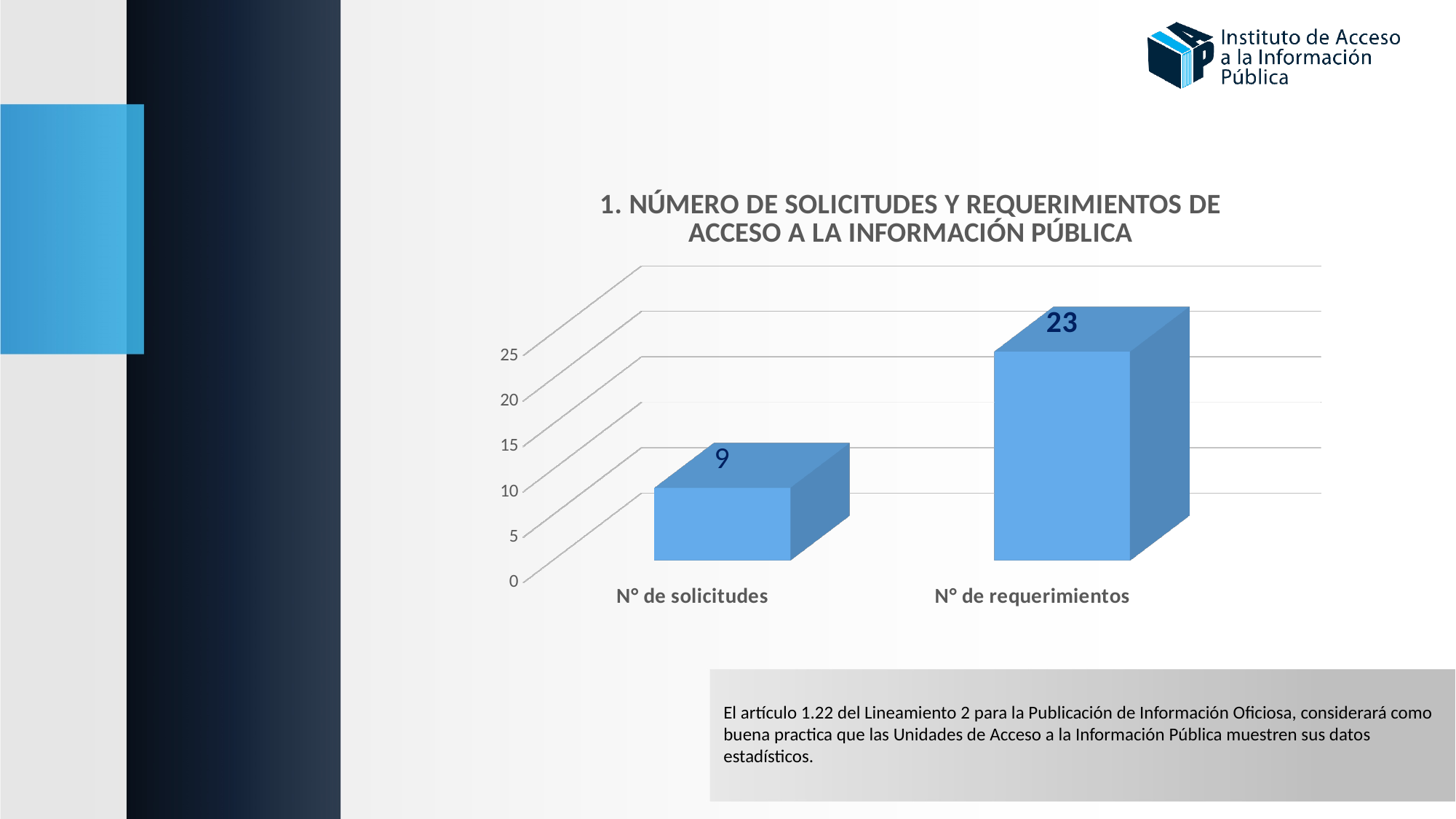
Is the value for N° de solicitudes greater or less than 10? less Which is larger, N° de solicitudes or N° de requerimientos? N° de requerimientos How many categories are shown in the chart? 2 What is the difference between N° de requerimientos and N° de solicitudes? 14 What kind of chart is shown on the slide? bar chart What is the title of the chart? 1. NÚMERO DE SOLICITUDES Y REQUERIMIENTOS DE ACCESO A LA INFORMACIÓN PÚBLICA Is the value for N° de requerimientos greater or less than 20? greater Which category has the lowest value? N° de solicitudes Which category has the highest value? N° de requerimientos What is the value for N° de solicitudes? 9 What is the highest value shown on the vertical axis? 25 What is the value for N° de requerimientos? 23